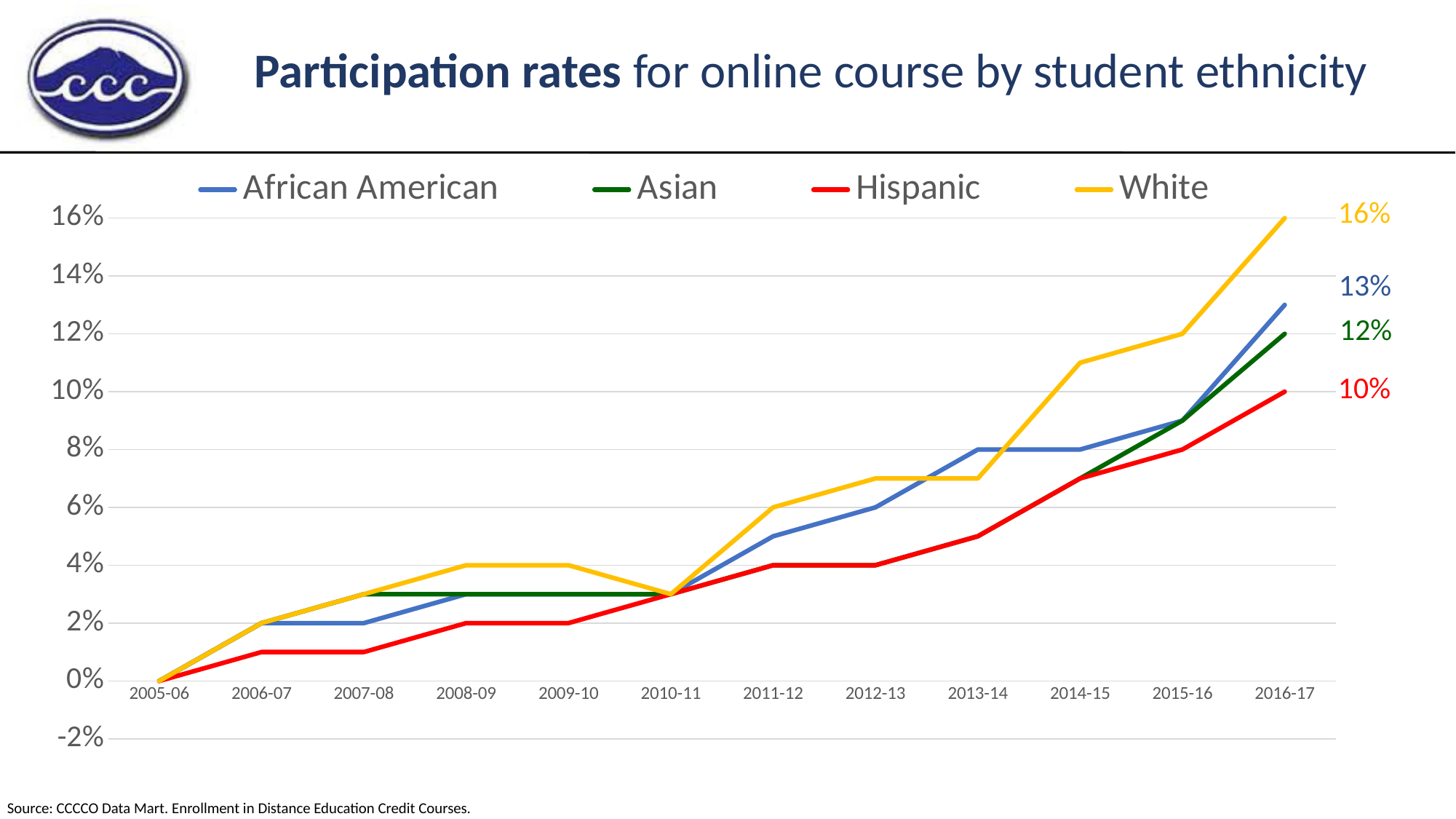
Do the participation rates generally rise or fall from 2005-06 to 2016-17? rise In 2016-17, is the participation rate higher for African American or Asian students? African American How many series does the legend list? 4 What is the participation rate for Hispanic students in 2016-17? 10% What is the difference between the White and African American participation rates in 2016-17? 3% Which ethnicity has the highest participation rate in 2016-17? White What is the participation rate for Asian students in 2016-17? 12% How many academic years are plotted along the x axis? 12 Which ethnicity has the lowest participation rate in 2016-17? Hispanic Is the participation rate for Hispanic students in 2013-14 greater or less than 6%? less What is the participation rate for White students in 2016-17? 16% What type of chart is shown on the slide? line chart